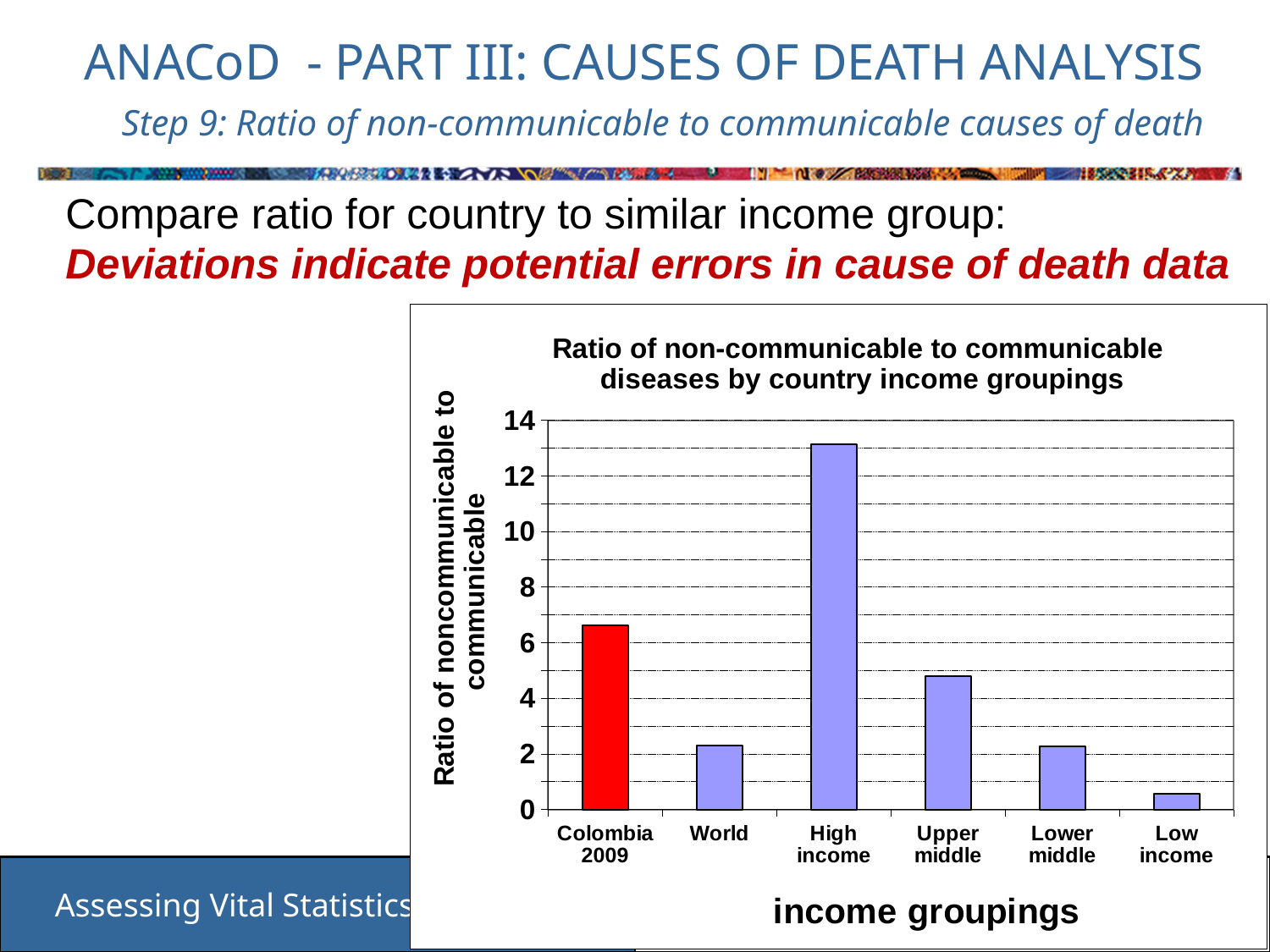
Is the value for Colombia 2009 greater or less than 6? greater Which income grouping has the highest ratio of non-communicable to communicable diseases? High income Which bar in the chart is coloured red? Colombia 2009 What kind of chart is shown on the slide? bar chart How many categories are shown on the x axis of the chart? 6 Is the value for Upper middle greater or less than 6? less What is the title of the chart? Ratio of non-communicable to communicable diseases by country income groupings Is the value for High income greater or less than 12? greater Which category has the lowest ratio of non-communicable to communicable diseases? Low income Which has a larger ratio, Colombia 2009 or Upper middle? Colombia 2009